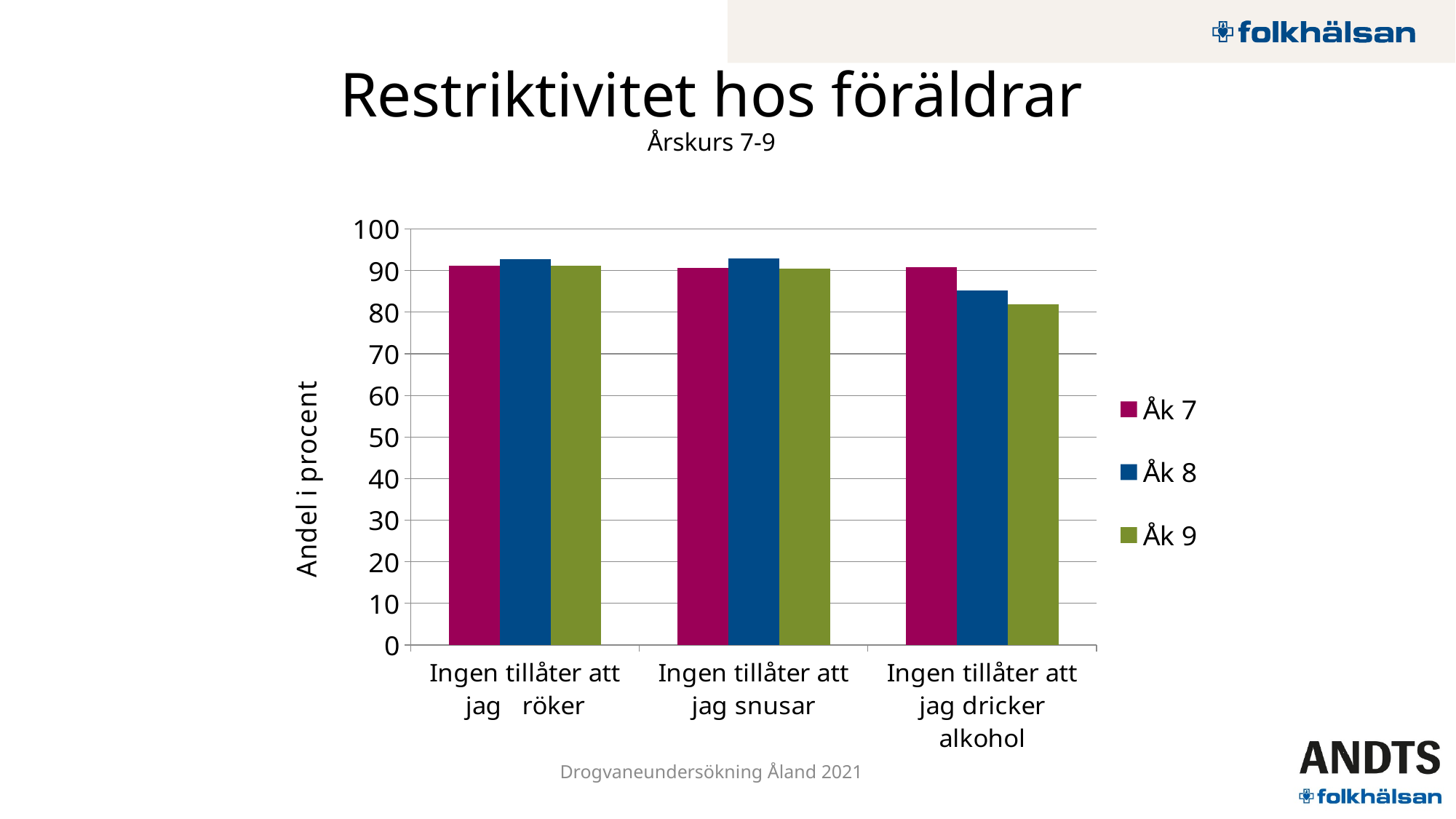
What kind of chart is shown on the slide? bar chart Is the value for Åk 9 in 'Ingen tillåter att jag dricker alkohol' greater or less than 90? less Is the value for Åk 8 in 'Ingen tillåter att jag dricker alkohol' greater or less than 90? less How many categories are shown on the x axis? 3 Which series has the highest value for 'Ingen tillåter att jag dricker alkohol'? Åk 7 How many series does the legend list? 3 What is the label of the y axis? Andel i procent Which series has the lowest value for 'Ingen tillåter att jag dricker alkohol'? Åk 9 Is the value for Åk 8 in 'Ingen tillåter att jag röker' greater or less than 90? greater What colour are the Åk 8 bars? blue For 'Ingen tillåter att jag dricker alkohol', which is larger: Åk 8 or Åk 9? Åk 8